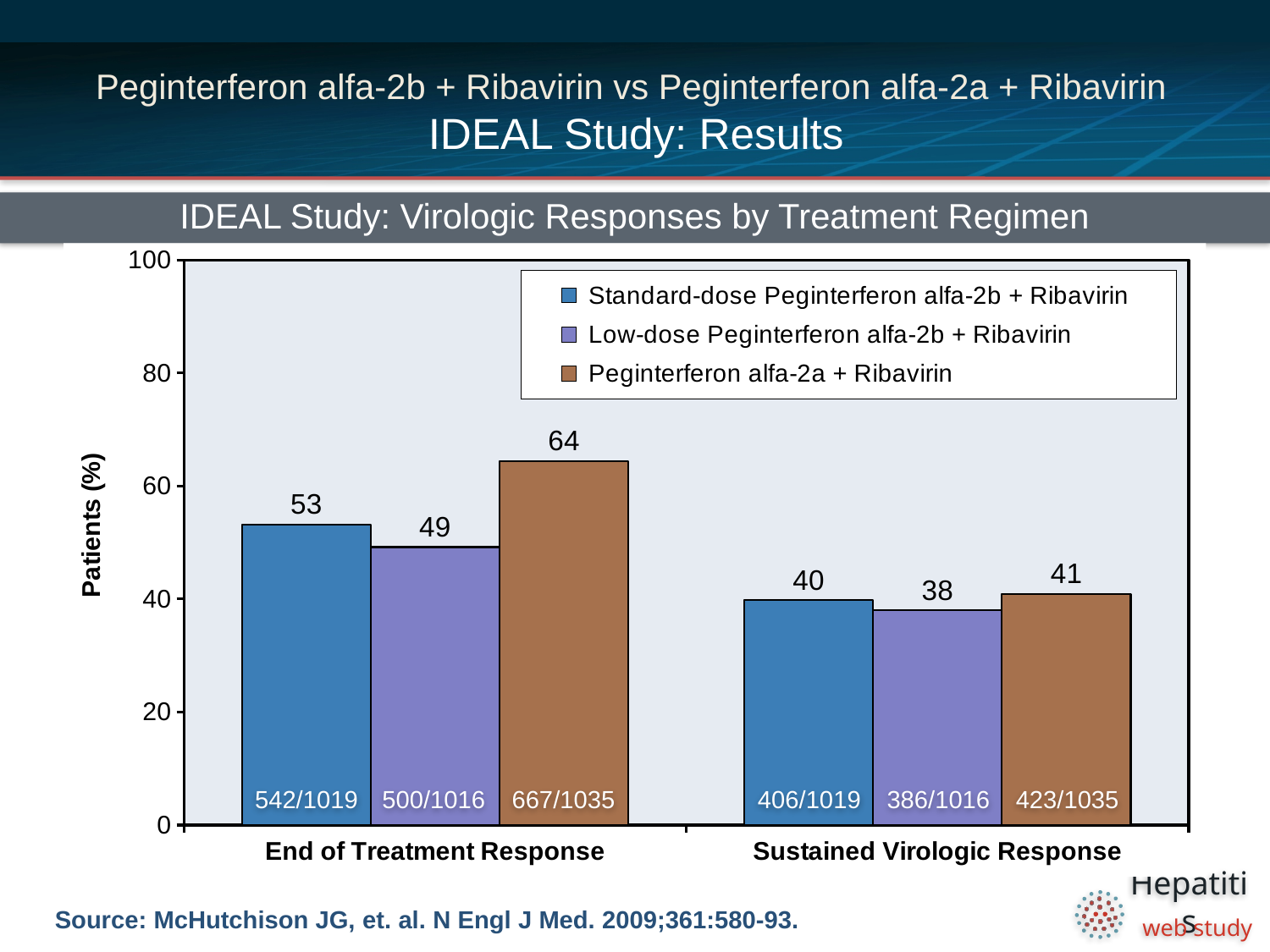
Is the End of Treatment Response for Peginterferon alfa-2a + Ribavirin greater or less than 60? greater How many series does the legend list? 3 Which treatment regimen has the lowest Sustained Virologic Response? Low-dose Peginterferon alfa-2b + Ribavirin What is the Sustained Virologic Response value for Low-dose Peginterferon alfa-2b + Ribavirin? 38 What is the label of the y axis? Patients (%) What is the End of Treatment Response value for Standard-dose Peginterferon alfa-2b + Ribavirin? 53 How many categories are shown on the x axis? 2 What kind of chart is shown on the slide? Bar chart What is the Sustained Virologic Response value for Peginterferon alfa-2a + Ribavirin? 41 Which treatment regimen has the highest End of Treatment Response? Peginterferon alfa-2a + Ribavirin Which is larger: the End of Treatment Response for Standard-dose Peginterferon alfa-2b + Ribavirin or for Low-dose Peginterferon alfa-2b + Ribavirin? Standard-dose Peginterferon alfa-2b + Ribavirin What is the difference between the End of Treatment Response for Peginterferon alfa-2a + Ribavirin and for Standard-dose Peginterferon alfa-2b + Ribavirin? 11